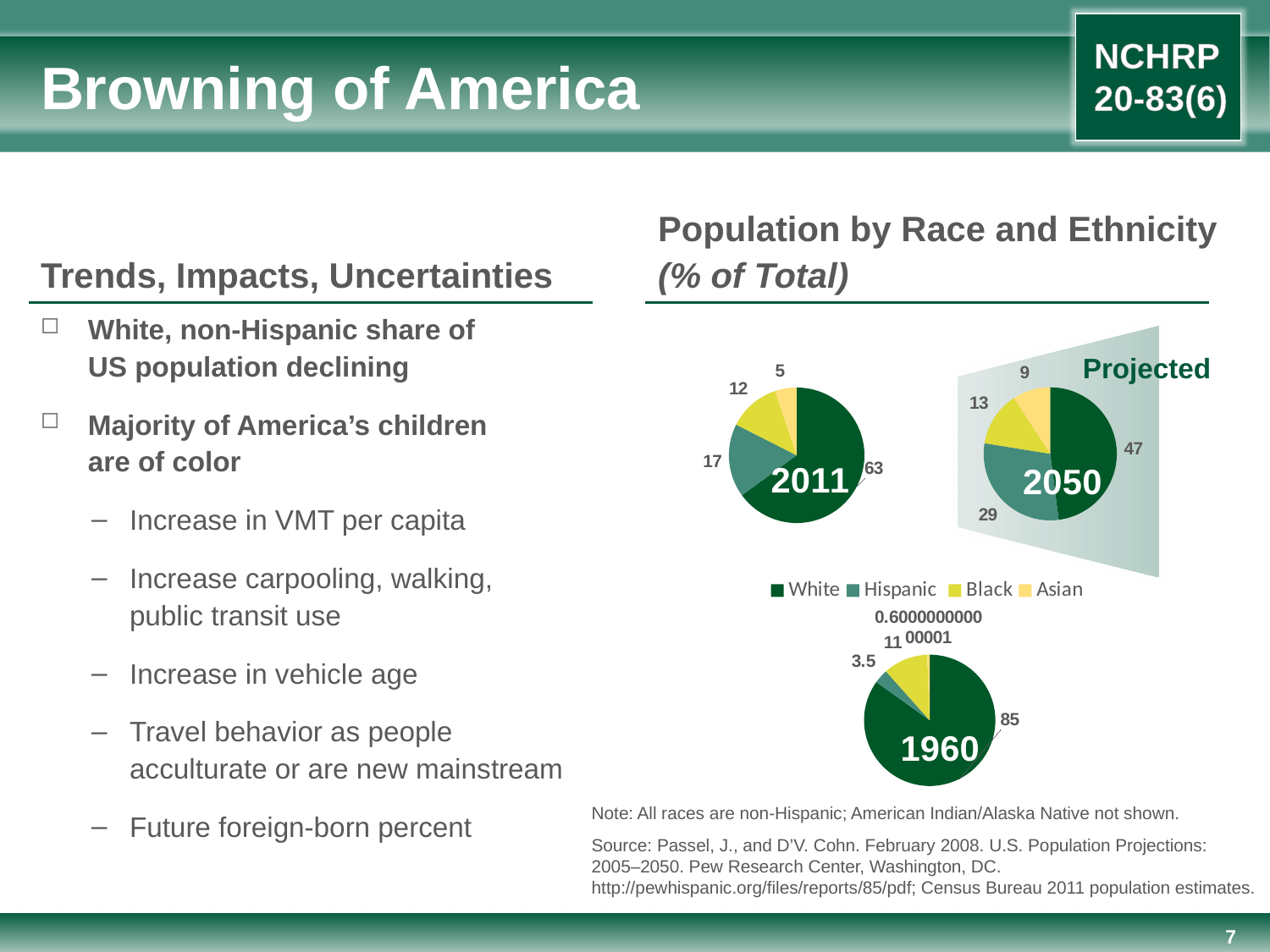
In the 1960 pie chart, what is the value for White? 85 Which pie chart is labelled as 'Projected'? 2050 In the 2050 pie chart, which is larger, the Black value or the Asian value? Black How many series does the legend list? 4 How does the White share change from the 1960 pie chart to the 2050 pie chart? It falls In the 2011 pie chart, what is the value for White? 63 In the 2011 pie chart, which group has the smallest share? Asian What kind of charts are shown under the title 'Population by Race and Ethnicity'? Pie charts In the 2050 pie chart, which group has the largest share? White What is the difference between the White value in the 2011 pie chart and the White value in the 2050 pie chart? 16 In the 2050 pie chart, what is the value for Hispanic? 29 In the 2011 pie chart, what is the value for Asian? 5